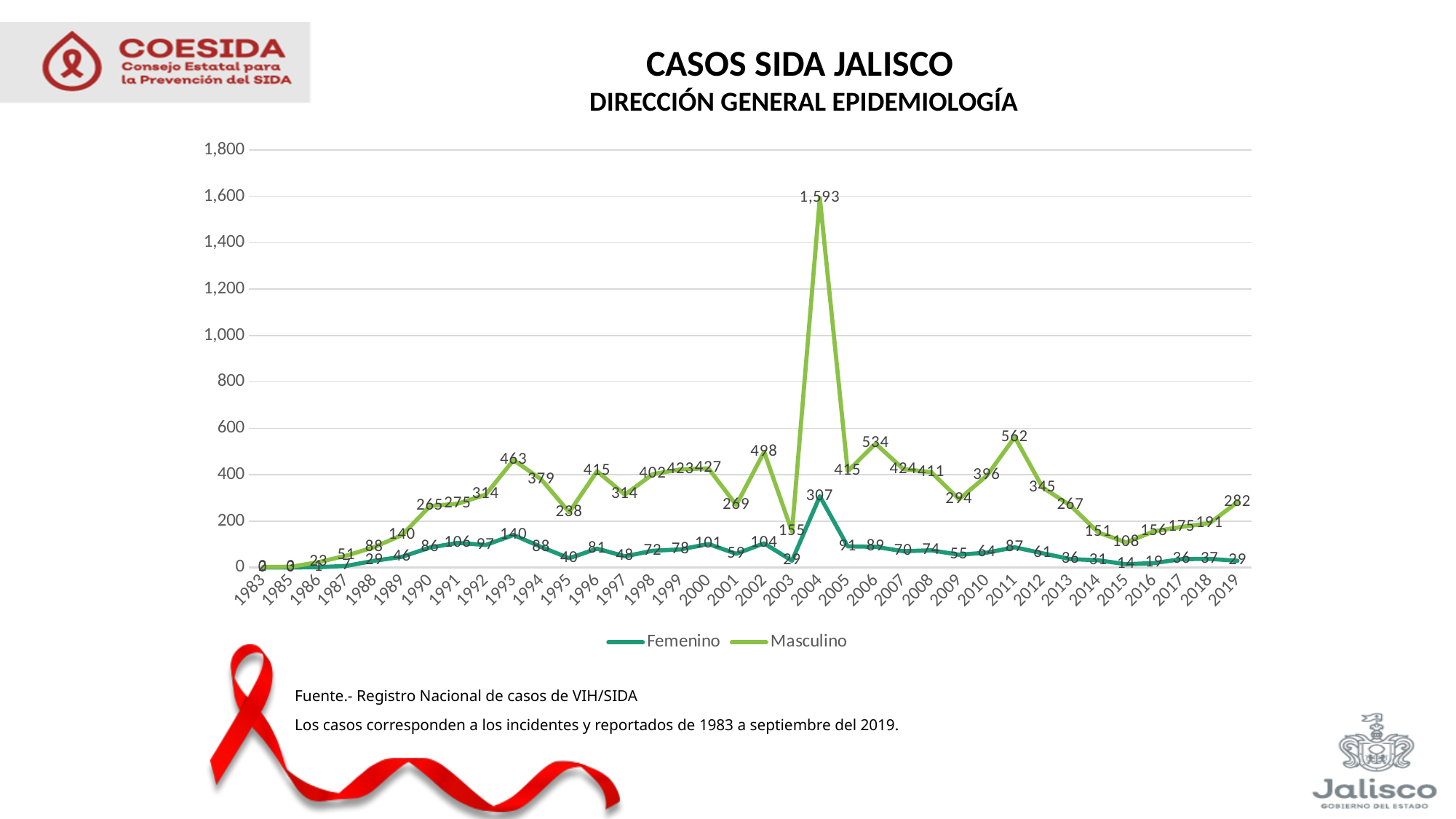
What type of chart is shown on the slide? line chart What is the Femenino value for 2004? 307 Does the Masculino series rise or fall from 2015 to 2019? rise What is the difference between the Masculino and Femenino values in 2004? 1,286 Is the Masculino value for 2004 greater or less than 1,000? greater What is the difference between the Masculino and Femenino values in 2019? 253 How many series does the legend list? 2 In which year does the Masculino series reach its highest value? 2004 What is the Masculino value for 2019? 282 What is the Masculino value for 2004? 1,593 What is the title of the chart? CASOS SIDA JALISCO Which is larger, the Masculino value for 2011 or for 2006? 2011